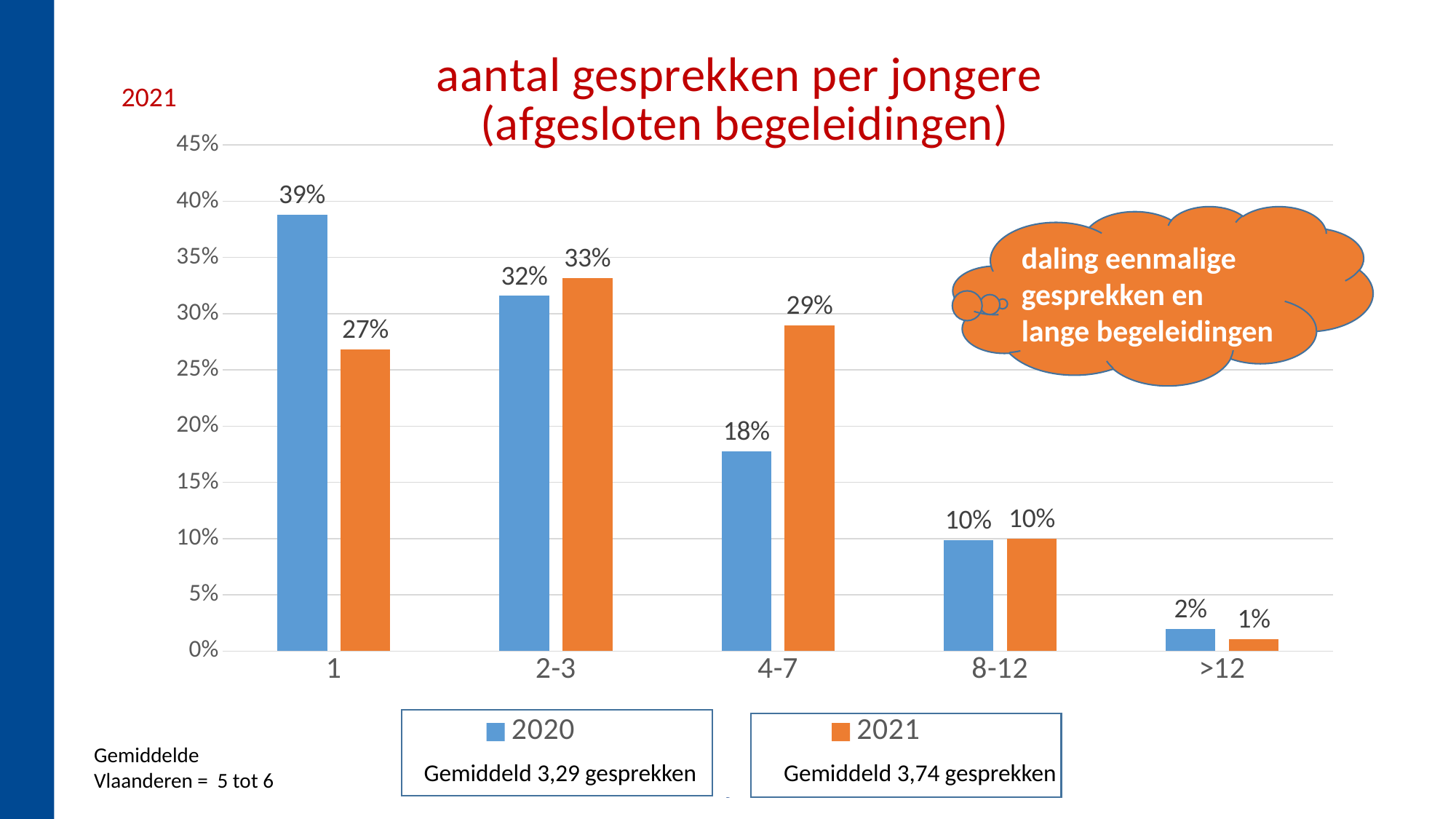
Is the 2021 value for the category "2-3" greater or less than 30%? greater Which category has the highest value for the 2020 series? 1 What is the value for 2021 in the category ">12"? 1% What is the title of the chart? aantal gesprekken per jongere (afgesloten begeleidingen) How many series does the legend list? 2 What kind of chart is shown on the slide? bar chart Which is larger in the category "4-7": the 2020 value or the 2021 value? 2021 Which category has the lowest value for the 2021 series? >12 What is the value for 2021 in the category "4-7"? 29% How many categories are shown on the x axis? 5 What is the value for 2020 in the category "1"? 39% What is the difference between the 2020 and 2021 values in the category "1"? 12%